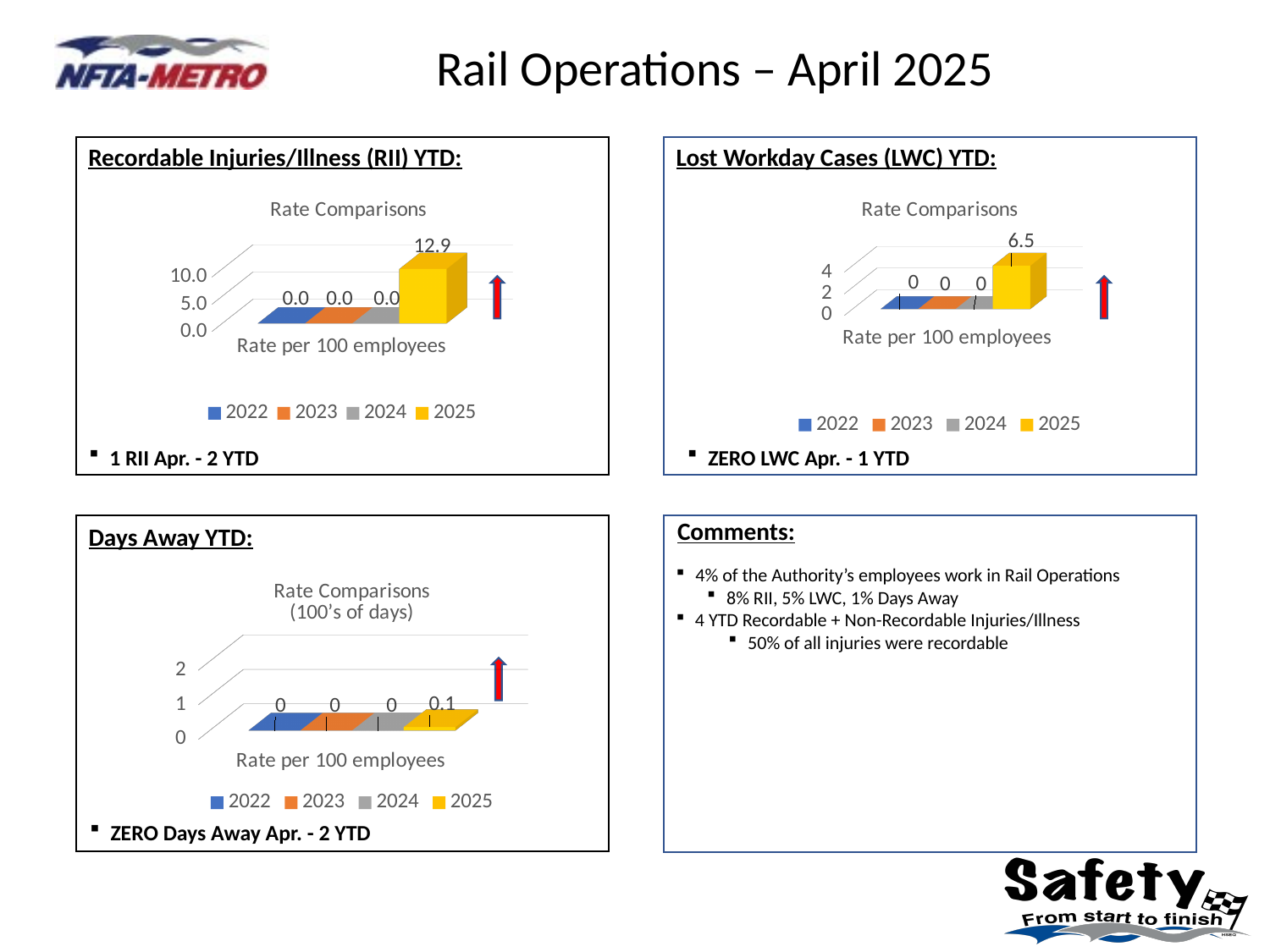
In the Lost Workday Cases (LWC) YTD chart, is the value for 2025 greater or less than 4? greater How many series does the legend of the Days Away YTD chart list? 4 In the Recordable Injuries/Illness (RII) YTD chart, what is the value for 2023? 0.0 What is the title shown above the plot area of the Days Away YTD chart? Rate Comparisons (100's of days) What kind of chart is the Recordable Injuries/Illness (RII) YTD chart? Bar chart In the Lost Workday Cases (LWC) YTD chart, which year has the highest value? 2025 In the Recordable Injuries/Illness (RII) YTD chart, what is the value for 2025? 12.9 In the Recordable Injuries/Illness (RII) YTD chart, what is the difference between the 2025 value and the 2024 value? 12.9 In the Lost Workday Cases (LWC) YTD chart, what is the value for 2025? 6.5 In the Days Away YTD chart, is the value for 2025 greater or less than 1? less In the Recordable Injuries/Illness (RII) YTD chart, which is larger, the value for 2025 or the value for 2022? 2025 In the Days Away YTD chart, what is the value for 2025? 0.1